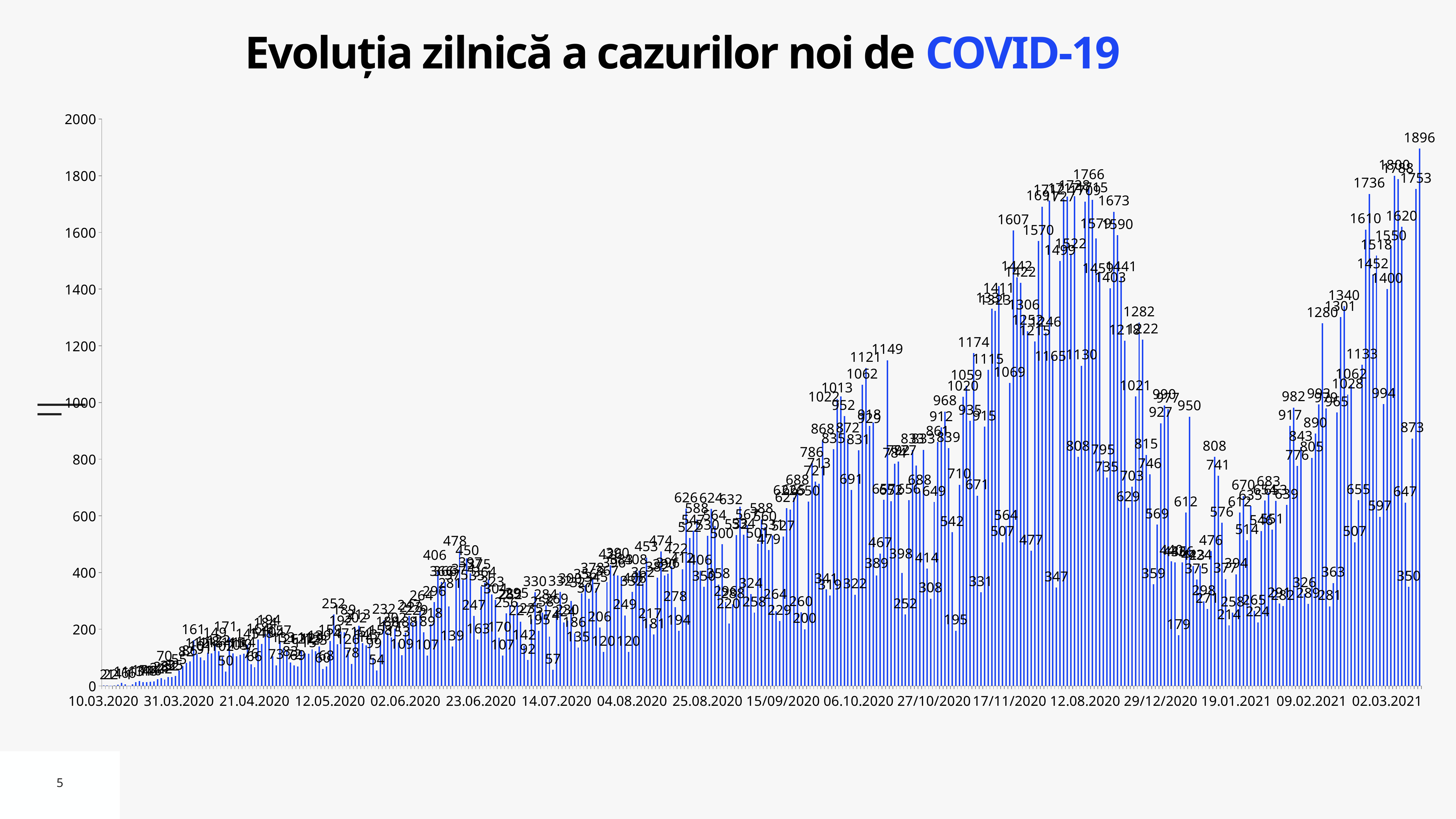
What is the title of the chart? Evoluția zilnică a cazurilor noi de COVID-19 What is the first date label on the horizontal axis? 10.03.2020 What is the last date label on the horizontal axis? 02.03.2021 What is the maximum value shown on the vertical axis? 2000 What kind of chart is shown on the slide? bar chart Is the tallest bar near the 12.08.2020 tick higher or lower than the tallest bar near the 02.03.2021 tick? lower Is the highest value in the chart greater or less than 1800? greater Do the values generally rise or fall from the start of the x axis (10.03.2020) to the end (02.03.2021)? rise What is the highest daily value shown in the chart? 1896 How many date labels are shown on the horizontal axis? 18 Are the values near the 10.03.2020 tick greater or less than 200? less Is the highest value in the chart greater or less than 2000? less